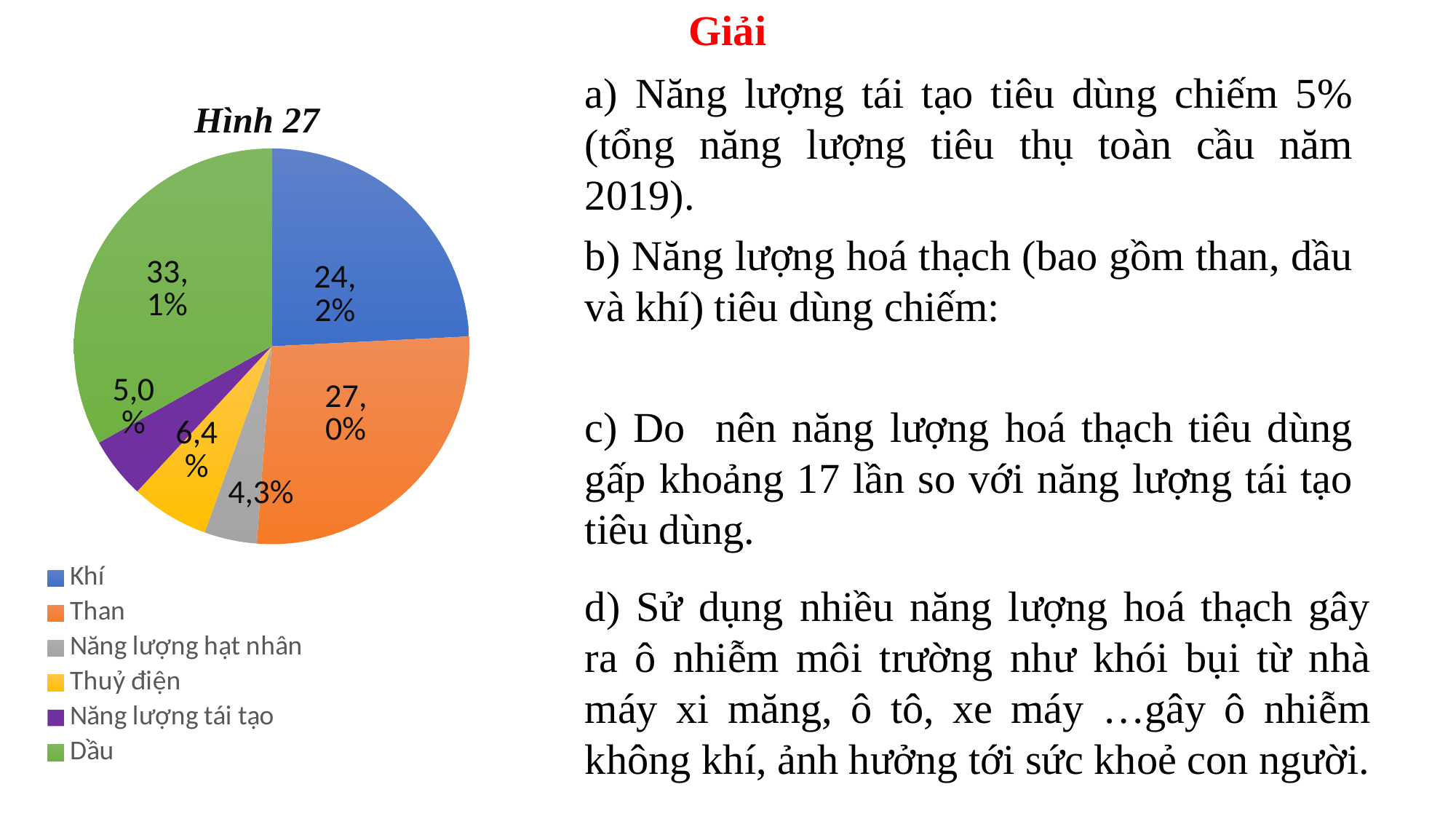
How many categories does the pie chart have? 6 What is the value shown for Thuỷ điện? 6,4% What is the value shown for Năng lượng hạt nhân? 4,3% What share of the pie does Dầu take? 33,1% Which category has the smallest slice of the pie? Năng lượng hạt nhân What is the value shown for Khí? 24,2% What is the value shown for Than? 27,0% What kind of chart is shown on the slide? pie chart What is the title of the chart? Hình 27 Which category has the largest slice of the pie? Dầu Which is larger, the slice for Than or the slice for Khí? Than What is the value shown for Năng lượng tái tạo? 5,0%